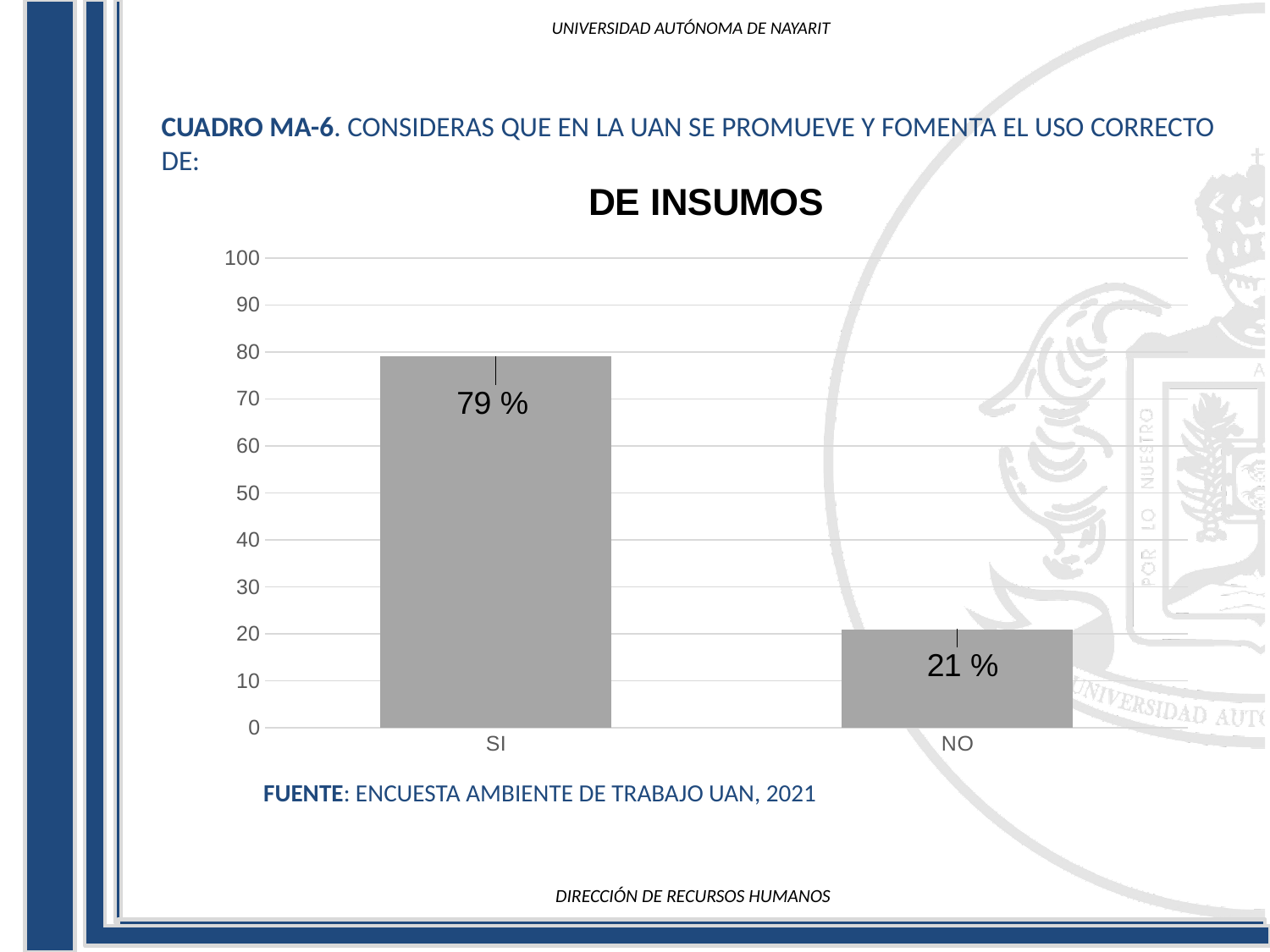
Which category has the highest value? SI What is the value for NO? 21 % Is the value for SI greater or less than 70? greater What is the highest value shown on the y axis? 100 What kind of chart is shown? bar chart What is the difference between the values for SI and NO? 58 % What is the title of the chart? DE INSUMOS Is the value for NO greater or less than 30? less How many categories are shown on the x axis? 2 What is the value for SI? 79 % Which category has the lowest value? NO Which is larger, the value for SI or the value for NO? SI